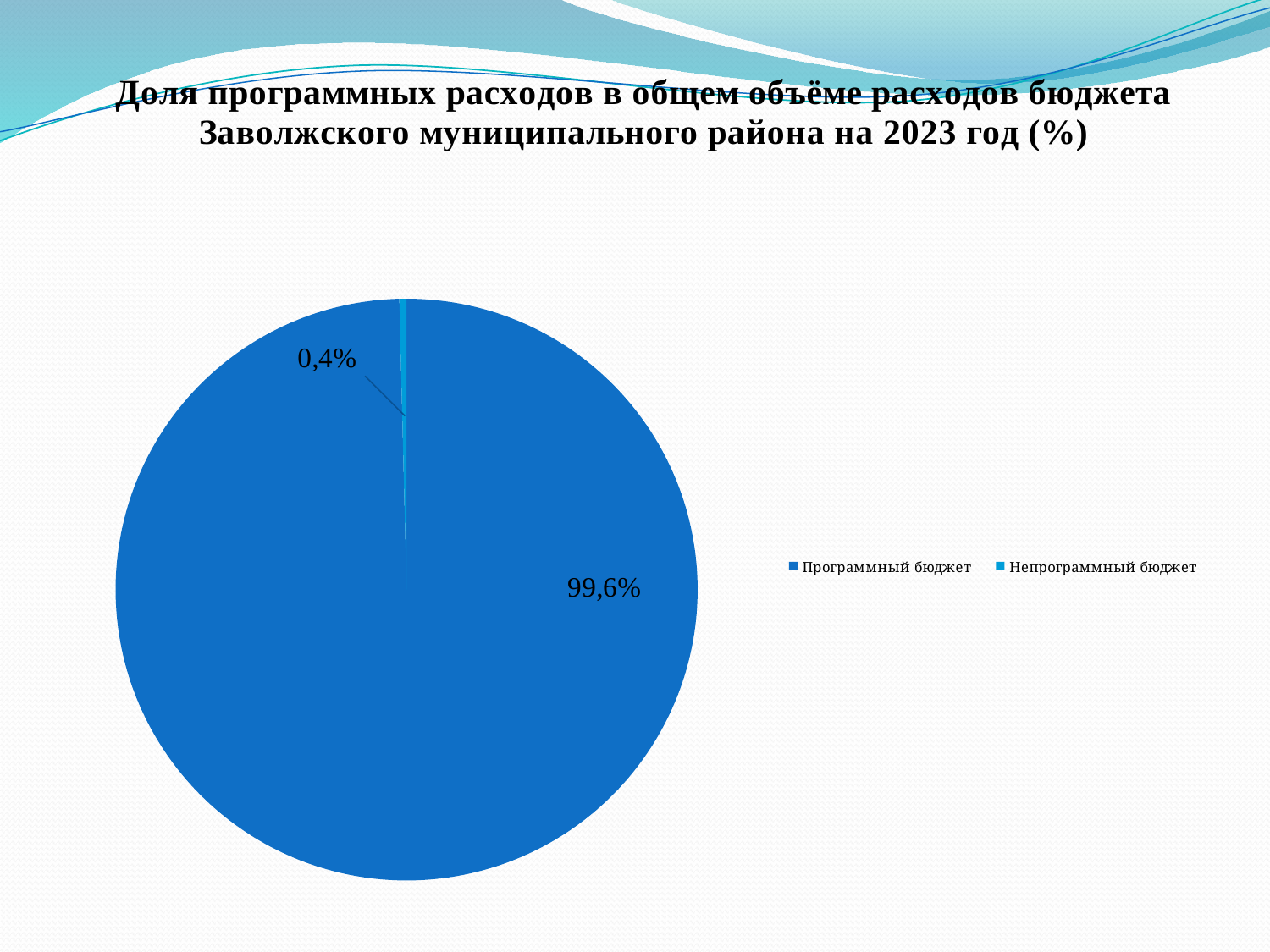
What is the total of the two slices shown? 100% What kind of chart is shown on the slide? pie chart Which category has the smallest share of the pie? Непрограммный бюджет Which year does the chart title refer to? 2023 How many slices does the pie chart have? 2 Which category has the largest share of the pie? Программный бюджет How many entries does the legend list? 2 What is the difference between the shares of Программный бюджет and Непрограммный бюджет? 99,2% Which legend entry is shown in the lighter blue colour? Непрограммный бюджет Which is larger: Программный бюджет or Непрограммный бюджет? Программный бюджет What is the value for Непрограммный бюджет? 0,4% What is the value for Программный бюджет? 99,6%